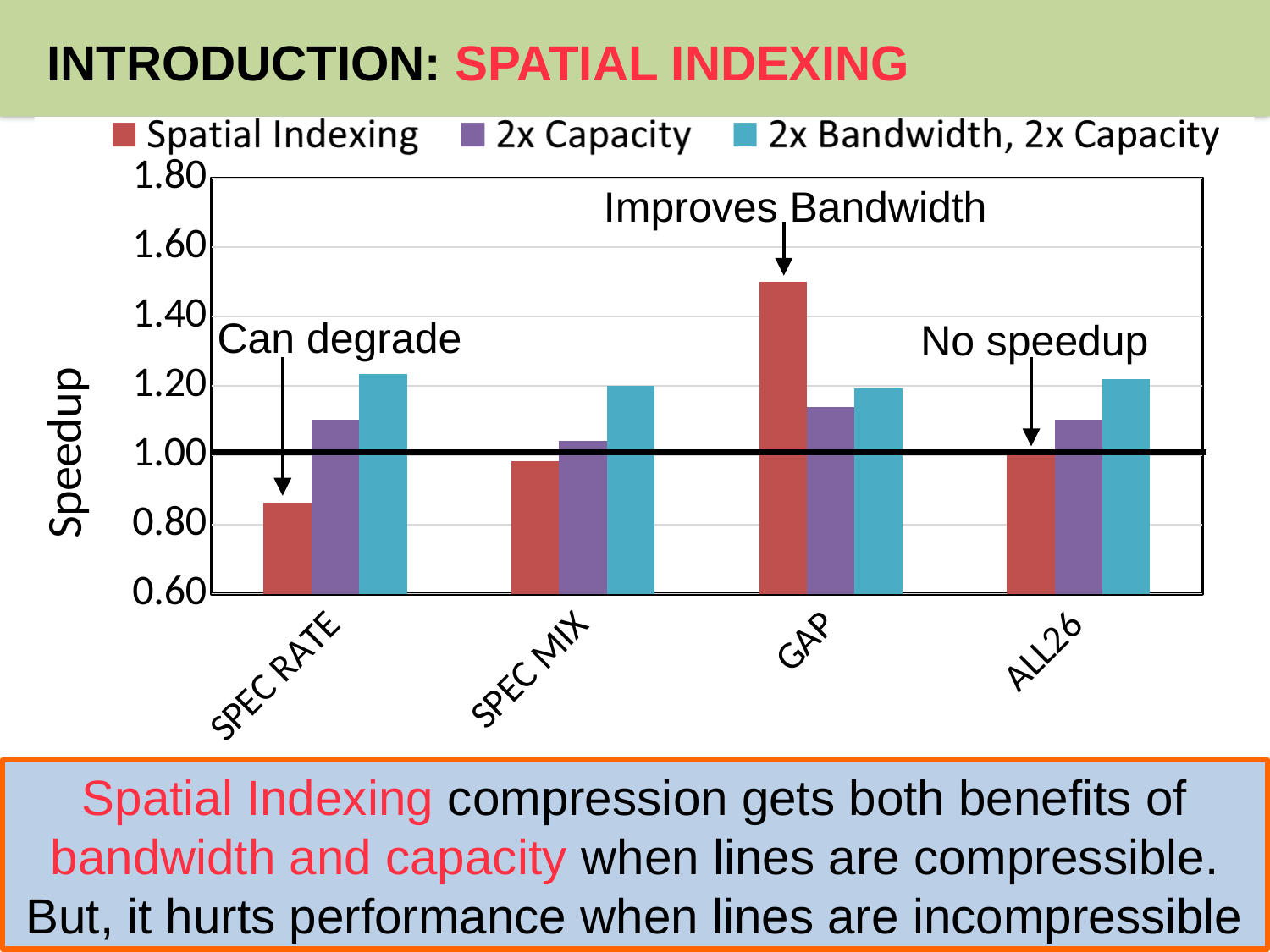
Is the 2x Capacity value for SPEC RATE greater or less than 1.00? greater For SPEC RATE, which is larger: the Spatial Indexing value or the 2x Bandwidth, 2x Capacity value? 2x Bandwidth, 2x Capacity How many series does the legend list? 3 For which category is the Spatial Indexing value lowest? SPEC RATE Is the Spatial Indexing value for GAP greater or less than 1.40? greater Is the Spatial Indexing value for SPEC RATE greater or less than 1.00? less For which category is the Spatial Indexing value highest? GAP What kind of chart is shown on the slide? bar chart What is the label of the y axis? Speedup How many categories are shown on the x axis? 4 Which annotation points to the Spatial Indexing bar for GAP? Improves Bandwidth For GAP, which is larger: the Spatial Indexing value or the 2x Capacity value? Spatial Indexing